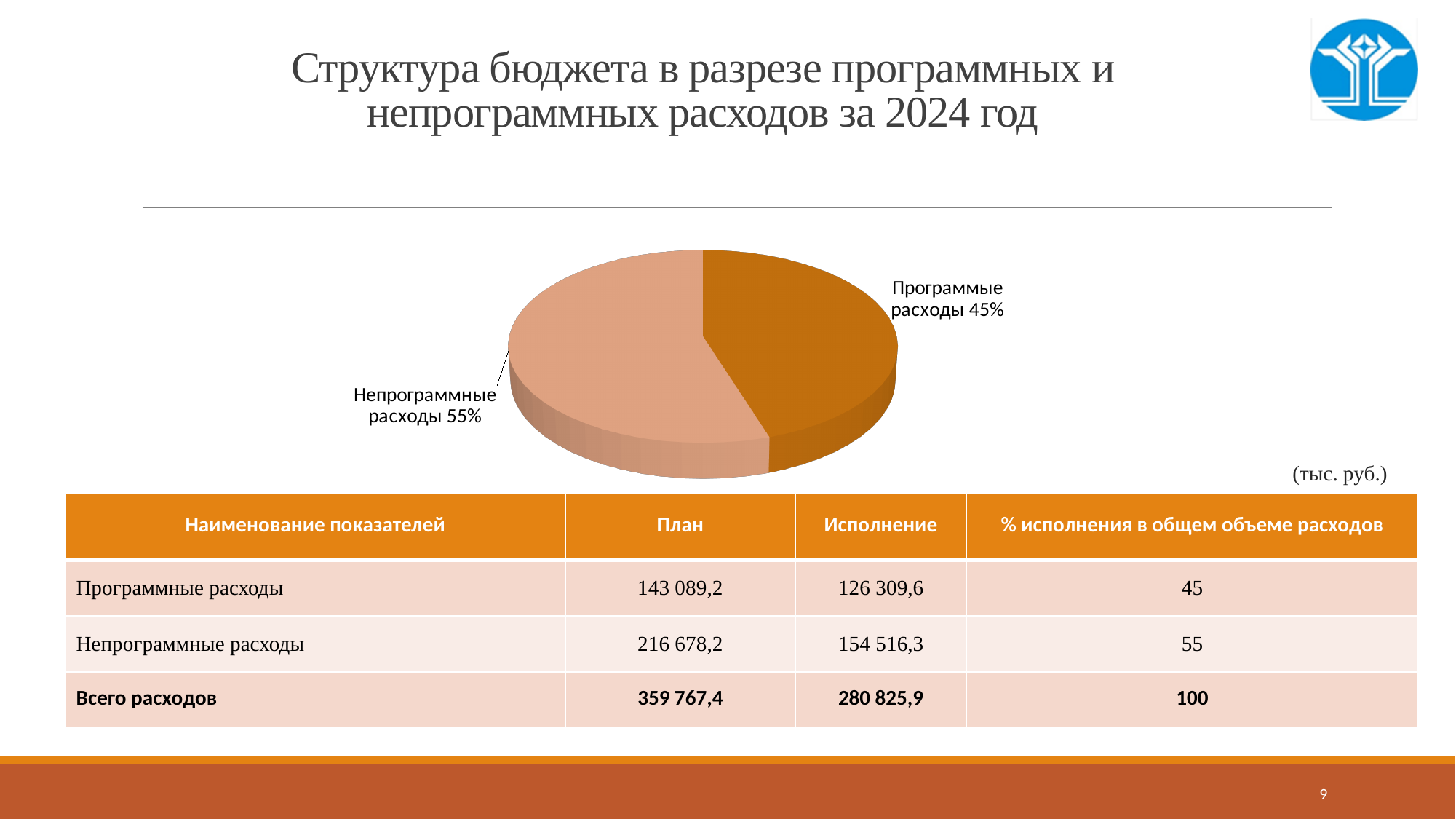
What share of the pie does Программные расходы represent? 45% Which slice of the pie chart is shown in the darker orange colour? Программные расходы What share of the pie does Непрограммные расходы represent? 55% Which slice of the pie chart is the largest? Непрограммные расходы Which slice of the pie chart is the smallest? Программные расходы How many slices does the pie chart have? 2 What kind of chart is shown on the slide? pie chart What is the difference in percentage points between the Непрограммные расходы slice and the Программные расходы slice? 10 What is the title of the slide containing the pie chart? Структура бюджета в разрезе программных и непрограммных расходов за 2024 год Which is larger in the pie chart, Программные расходы or Непрограммные расходы? Непрограммные расходы Is the share for Непрограммные расходы greater or less than 50%? greater Is the share for Программные расходы greater or less than 50%? less